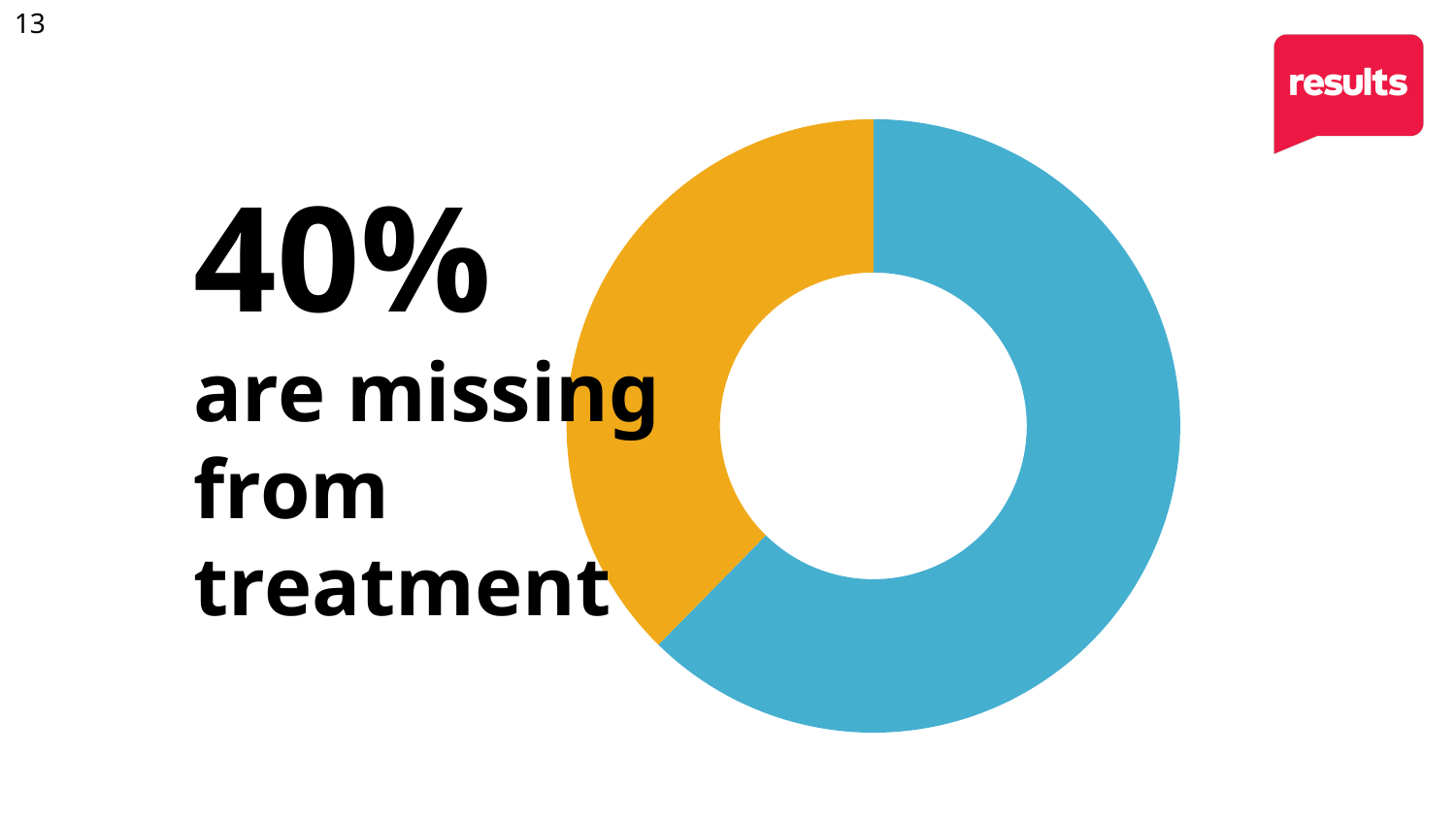
What two colours are used for the slices of the donut chart? Blue and orange How many slices does the donut chart have? 2 What percentage is stated in the large text next to the chart? 40% What does the text next to the chart say the 40% represents? are missing from treatment Is the orange slice of the donut chart greater or less than 50% of the whole? less Which slice of the donut chart is larger, the blue one or the orange one? Blue Which slice of the donut chart is the smallest? The orange slice What kind of chart is shown on the slide? Pie chart (donut) Is the blue slice of the donut chart greater or less than 50% of the whole? greater